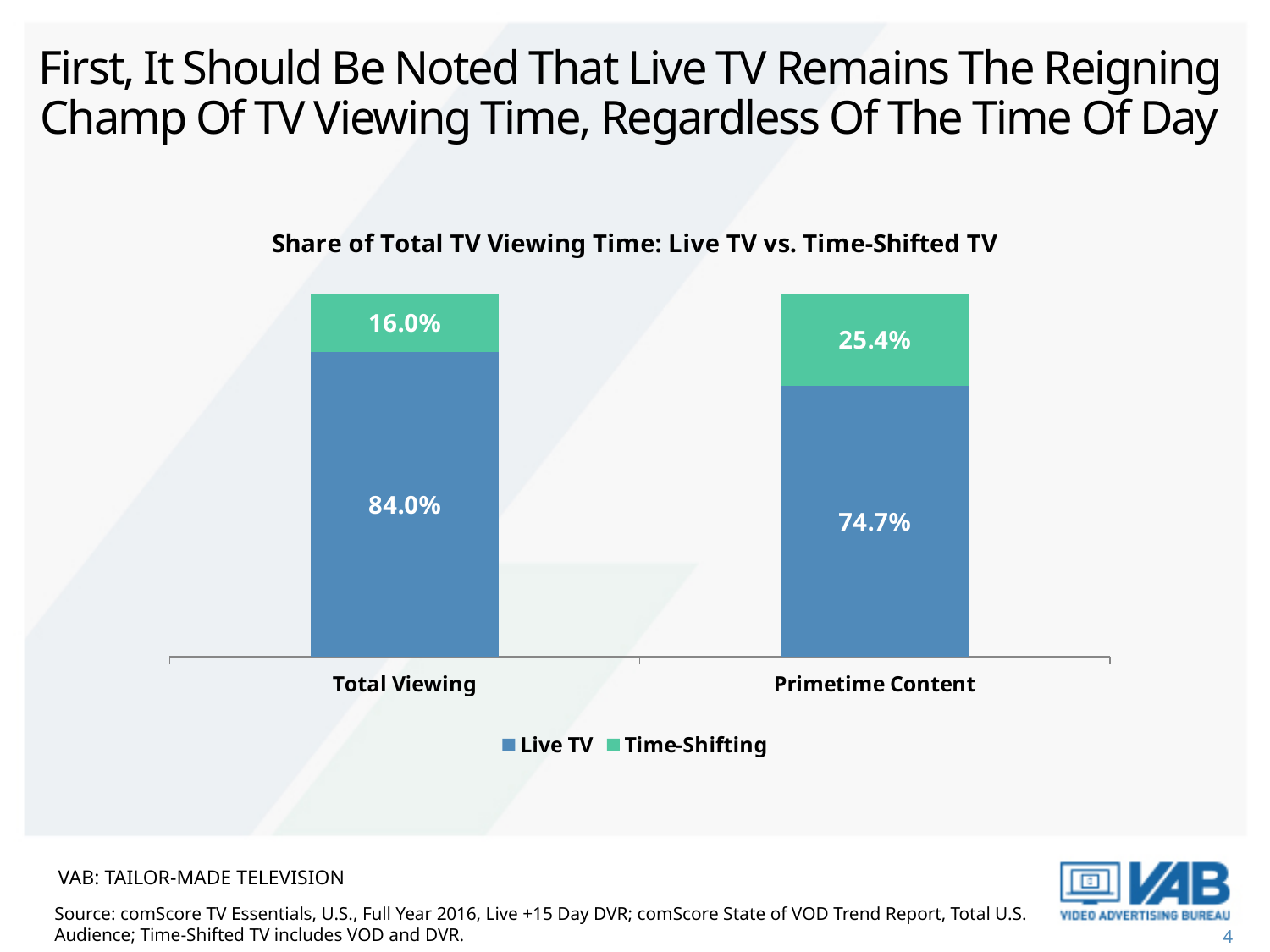
What is the total of the stacked bar for Total Viewing? 100.0% What is the Time-Shifting share for Total Viewing? 16.0% What is the difference between the Live TV shares for Total Viewing and Primetime Content? 9.3 percentage points What kind of chart is shown on the slide? Stacked bar chart What is the Live TV share for Primetime Content? 74.7% Which category has the highest Time-Shifting share? Primetime Content What is the difference between the Time-Shifting shares for Primetime Content and Total Viewing? 9.4 percentage points What is the Time-Shifting share for Primetime Content? 25.4% Which category has the higher Live TV share, Total Viewing or Primetime Content? Total Viewing How many series does the legend list? 2 What is the Live TV share for Total Viewing? 84.0% How many categories are shown on the x axis? 2